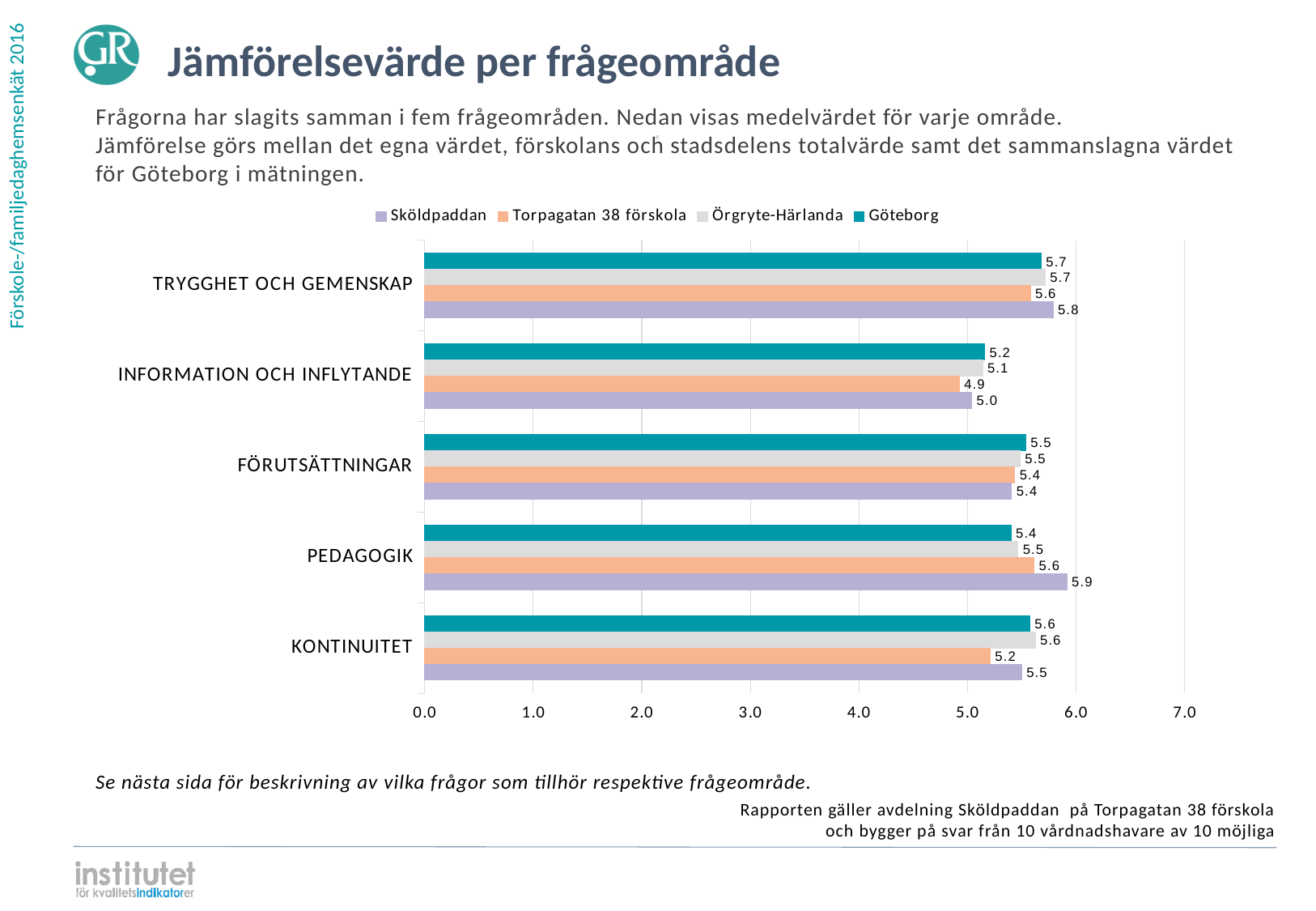
What kind of chart is shown on the slide? bar chart What is the value for Örgryte-Härlanda in the TRYGGHET OCH GEMENSKAP category? 5.7 In which category does Sköldpaddan have its highest value? PEDAGOGIK In which category does Torpagatan 38 förskola have its lowest value? INFORMATION OCH INFLYTANDE What is the value for Göteborg in the INFORMATION OCH INFLYTANDE category? 5.2 What is the value for Torpagatan 38 förskola in the KONTINUITET category? 5.2 In the KONTINUITET category, which is larger: the value for Sköldpaddan or the value for Torpagatan 38 förskola? Sköldpaddan What is the difference between the Sköldpaddan value and the Göteborg value in the PEDAGOGIK category? 0.5 How many categories (frågeområden) are shown on the chart? 5 Is the value for Torpagatan 38 förskola in the INFORMATION OCH INFLYTANDE category greater or less than 5.0? less How many series does the legend list? 4 What is the value for Sköldpaddan in the PEDAGOGIK category? 5.9